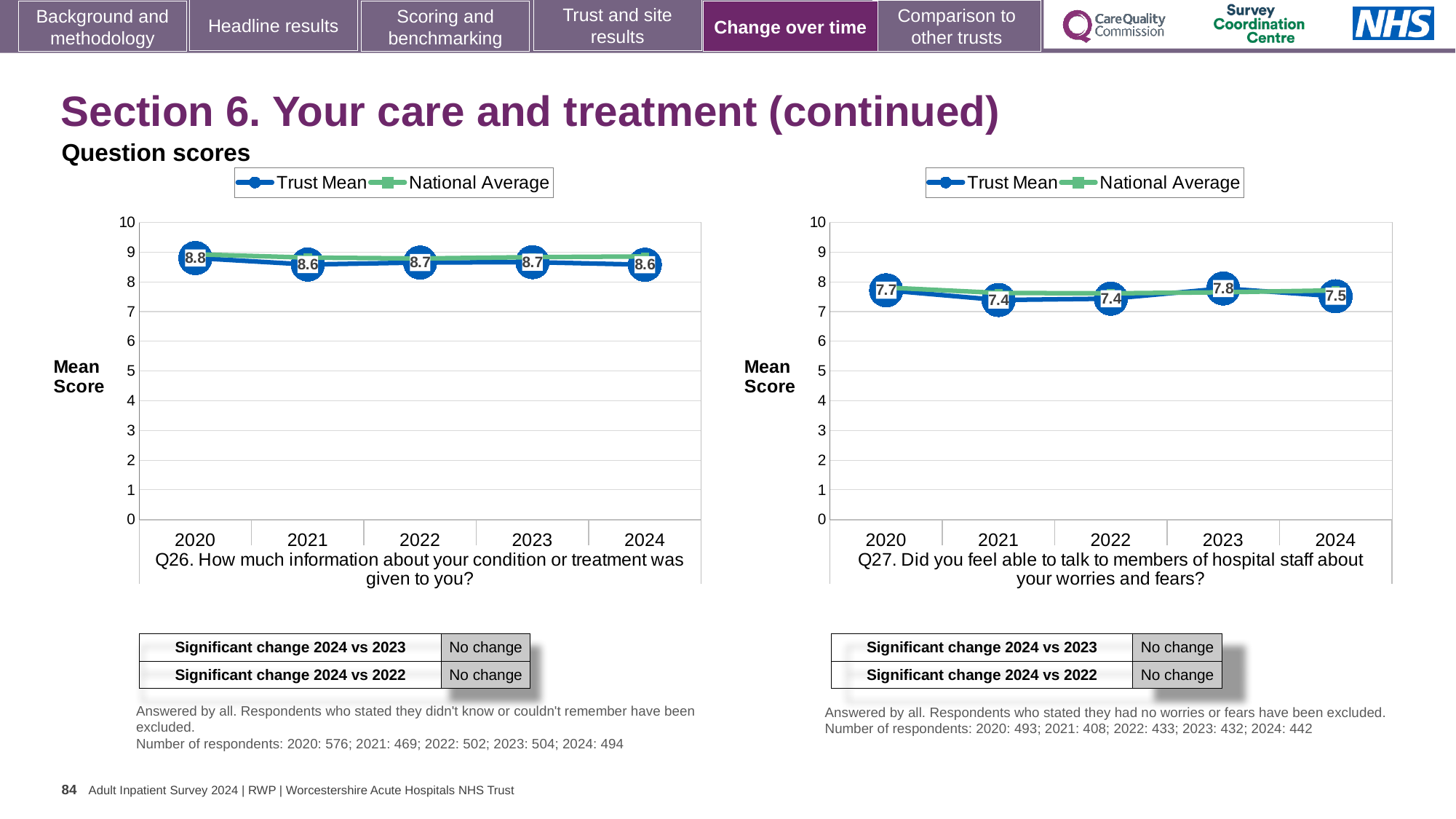
In the Q27 chart on the right, which year has the highest Trust Mean score? 2023 What kind of chart is the Q26 chart on the left? Line chart In the Q27 chart on the right, what is the Trust Mean score for 2023? 7.8 In the Q26 chart on the left, what is the difference between the Trust Mean scores for 2020 and 2024? 0.2 In the Q26 chart on the left, what is the Trust Mean score for 2020? 8.8 In the Q27 chart on the right, what is the difference between the Trust Mean scores for 2023 and 2021? 0.4 In the Q26 chart on the left, does the Trust Mean score rise or fall from 2020 to 2024? Fall In the Q26 chart on the left, which year has the highest Trust Mean score? 2020 In the Q26 chart on the left, is the National Average value for 2020 greater or less than 8? greater In the Q27 chart on the right, which year has the larger Trust Mean score, 2020 or 2021? 2020 How many years are plotted on the x axis of the Q27 chart on the right? 5 How many series does the legend of the Q26 chart on the left list? 2